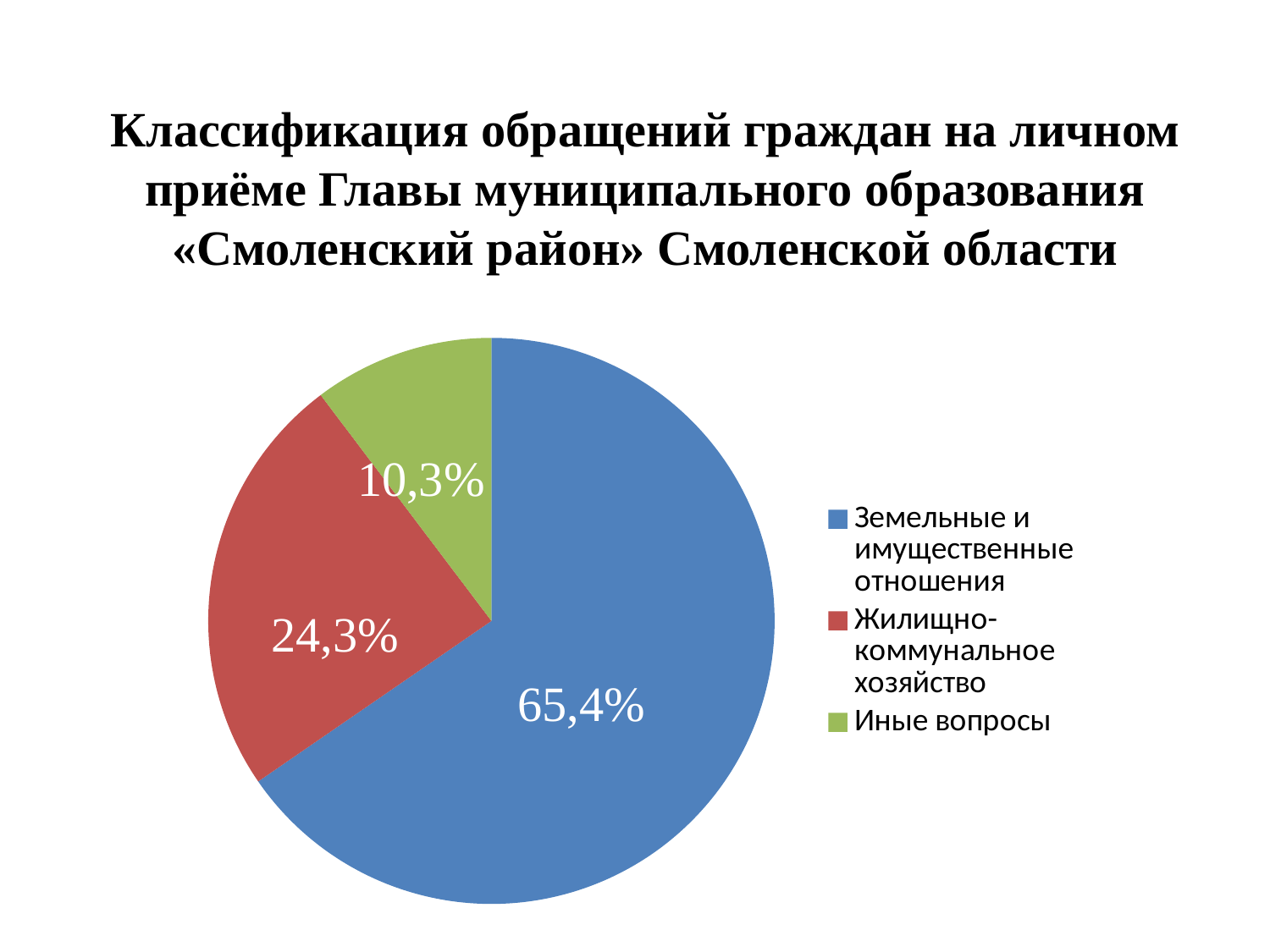
What colour is the slice for «Земельные и имущественные отношения»? blue What colour is the slice for «Иные вопросы»? green What is the difference in percentage points between «Земельные и имущественные отношения» and «Жилищно-коммунальное хозяйство»? 41,1 What share of the pie does «Земельные и имущественные отношения» have? 65,4% What share of the pie does «Жилищно-коммунальное хозяйство» have? 24,3% What share of the pie does «Иные вопросы» have? 10,3% How many slices does the pie chart have? 3 Which category has the smallest slice of the pie? Иные вопросы Which category has the largest slice of the pie? Земельные и имущественные отношения What kind of chart is shown on the slide? pie chart How many entries does the legend list? 3 Which is larger: the slice for «Жилищно-коммунальное хозяйство» or the slice for «Иные вопросы»? Жилищно-коммунальное хозяйство